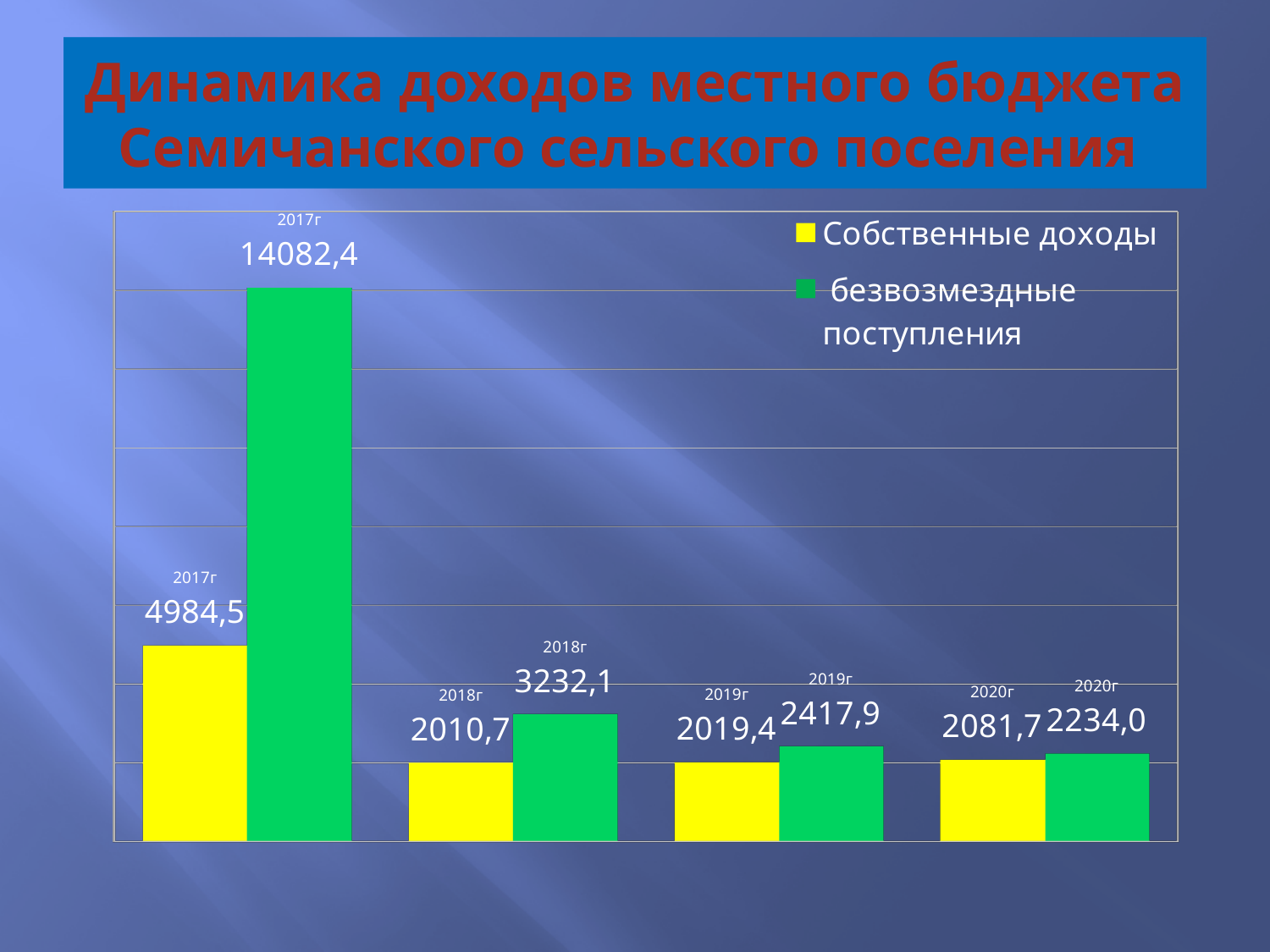
How many years are shown on the chart? 4 Which is larger in 2018г: Собственные доходы or безвозмездные поступления? безвозмездные поступления What is the value of безвозмездные поступления for 2019г? 2417,9 What is the value of безвозмездные поступления for 2020г? 2234,0 How many series does the legend list? 2 What is the value of Собственные доходы for 2017г? 4984,5 In which year is безвозмездные поступления highest? 2017г What type of chart is shown on the slide? bar chart In which year is Собственные доходы lowest? 2018г What is the difference between безвозмездные поступления and Собственные доходы in 2017г? 9097,9 What is the value of Собственные доходы for 2018г? 2010,7 What is the value of безвозмездные поступления for 2017г? 14082,4